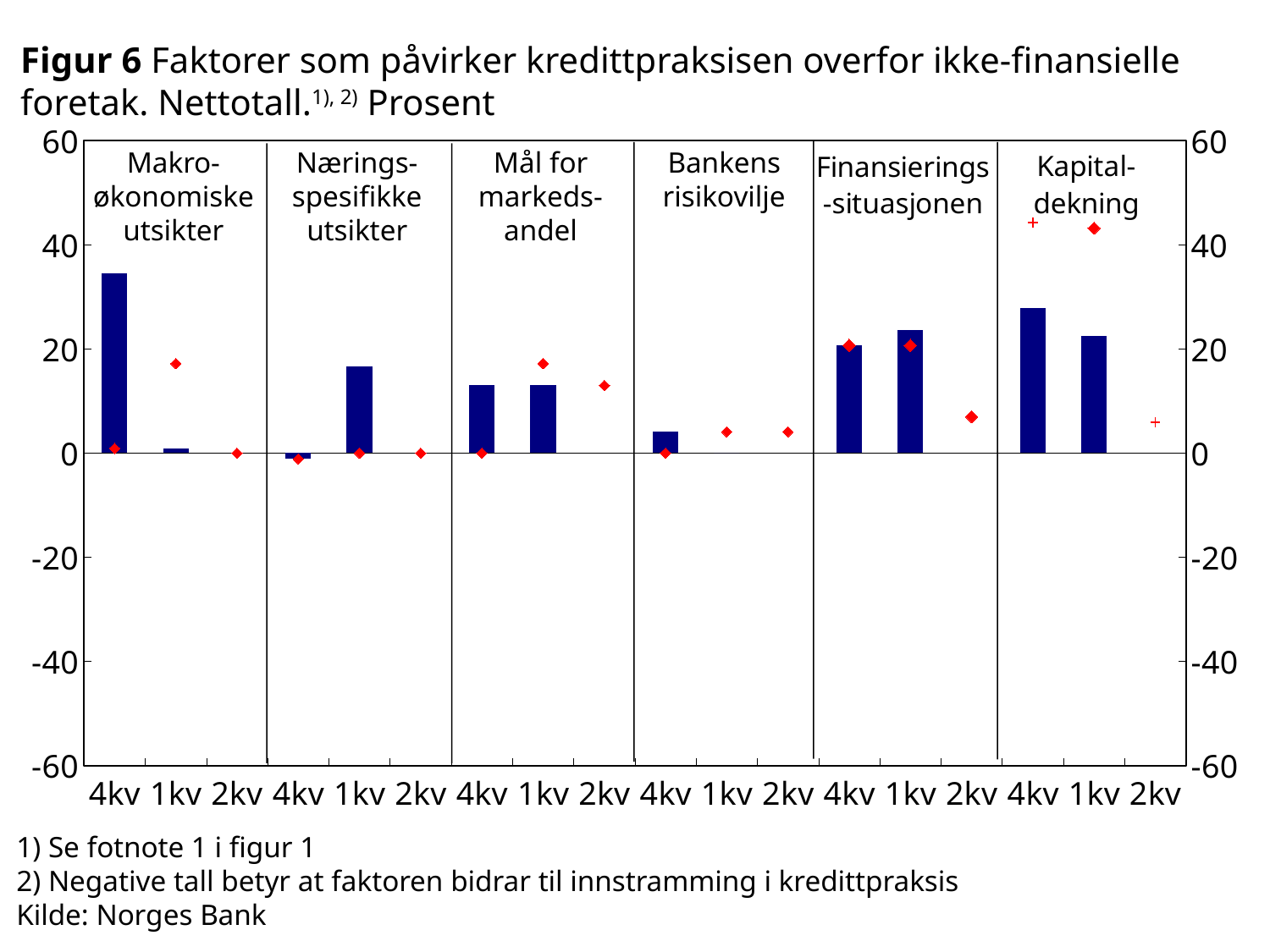
What is the source given for the chart? Norges Bank Is the 4kv bar for Næringsspesifikke utsikter greater or less than 0? less Is the 4kv bar for Makroøkonomiske utsikter greater or less than 20? greater How many quarters are shown on the x axis within each factor panel? 3 Which factor has the lowest bar for 4kv? Næringsspesifikke utsikter Is the 4kv bar for Kapitaldekning greater or less than 20? greater Which factor has the highest bar for 4kv? Makroøkonomiske utsikter How many factors (panels) are shown in the chart? 6 For Kapitaldekning, which bar is taller, 4kv or 1kv? 4kv What kind of chart is shown in Figur 6? combination chart (bars with point markers)